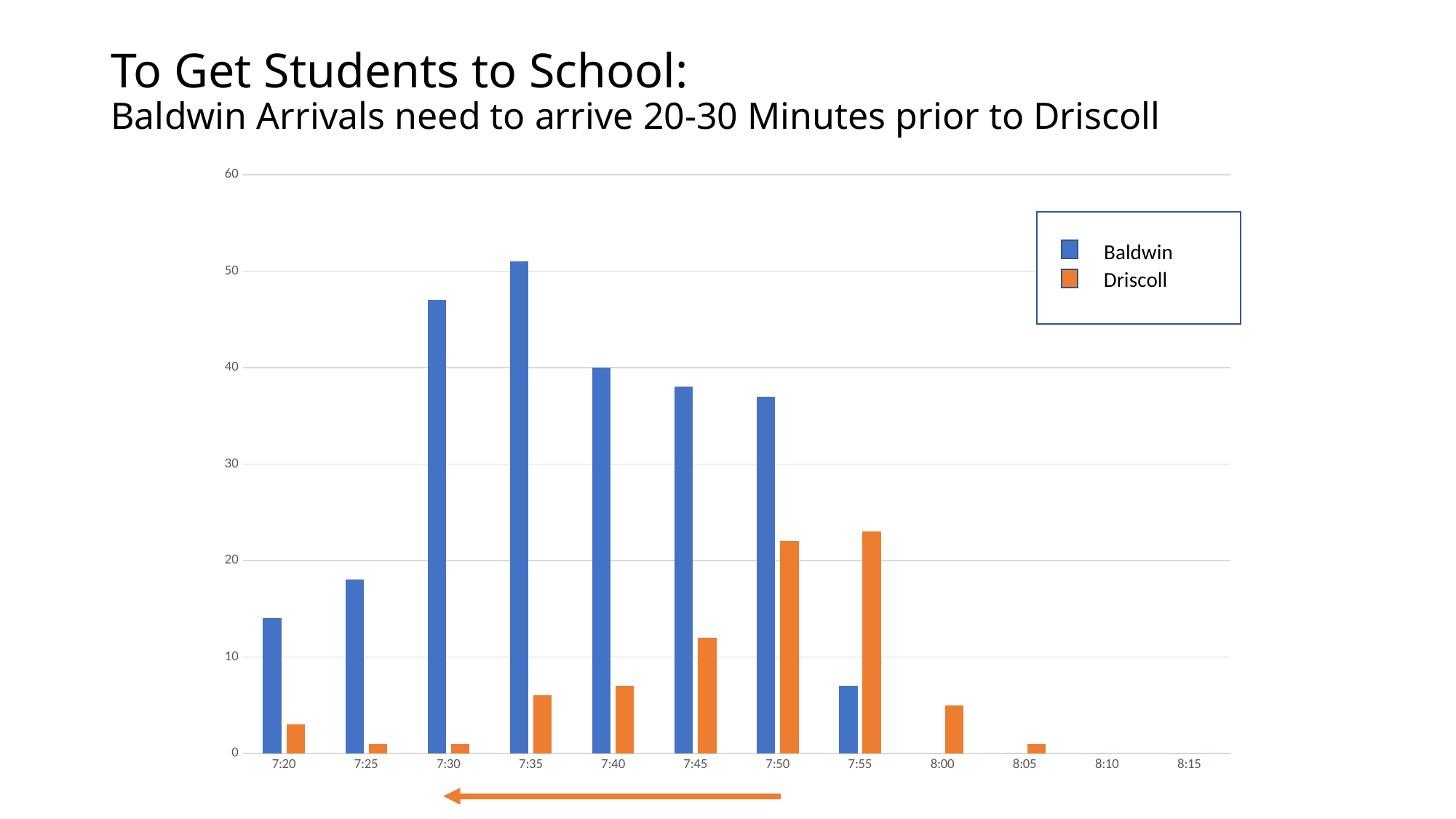
Is the Baldwin value at 7:55 greater or less than 10? less Is the Driscoll value at 7:50 greater or less than 20? greater Is the Baldwin value at 7:30 greater or less than 40? greater At 7:55, which series has the larger value, Baldwin or Driscoll? Driscoll Which two series are listed in the legend? Baldwin and Driscoll How many series does the legend list? 2 At 7:30, which series has the larger value, Baldwin or Driscoll? Baldwin Among the times where Baldwin has a bar, at which time is the Baldwin value lowest? 7:55 What kind of chart is shown on the slide? bar chart At which time is the Baldwin value highest? 7:35 How many time categories are shown on the x axis? 12 Do the Baldwin values rise or fall from 7:20 to 7:35? rise